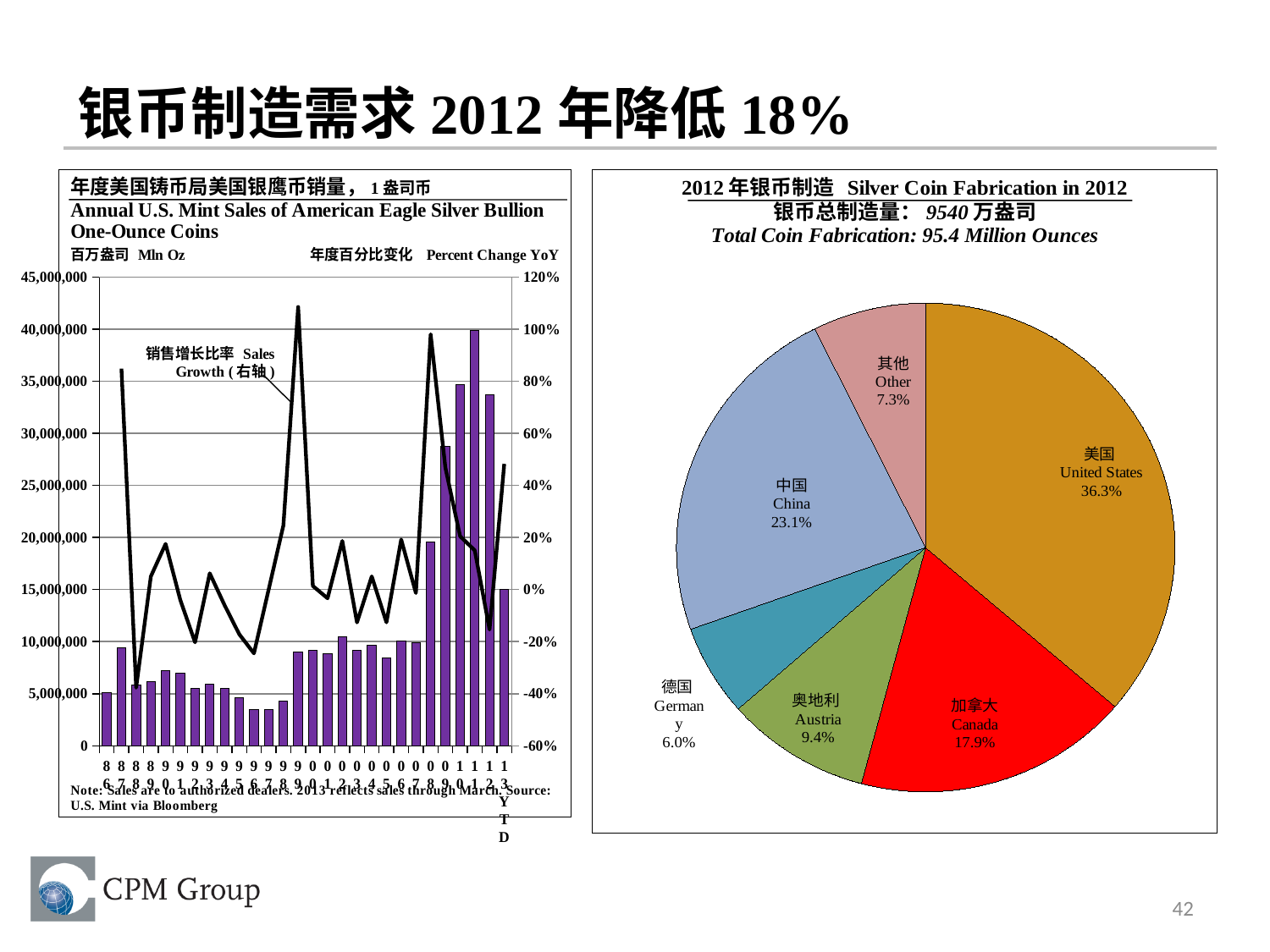
In the Silver Coin Fabrication in 2012 pie chart, what share does Canada have? 17.9% In the Silver Coin Fabrication in 2012 pie chart, what share does China have? 23.1% In the Silver Coin Fabrication in 2012 pie chart, what share does Germany have? 6.0% How many slices does the Silver Coin Fabrication in 2012 pie chart have? 6 In the Annual U.S. Mint Sales of American Eagle Silver Bullion One-Ounce Coins chart, is the tallest bar greater or less than 35,000,000? greater In the Silver Coin Fabrication in 2012 pie chart, which named slice has the smallest share? Germany In the Silver Coin Fabrication in 2012 pie chart, which country has the largest share? United States In the Silver Coin Fabrication in 2012 pie chart, what share does the United States have? 36.3% What kind of chart is the chart on the right side of the slide? Pie chart In the Silver Coin Fabrication in 2012 pie chart, how many percentage points larger is the United States share than the Canada share? 18.4 In the Silver Coin Fabrication in 2012 pie chart, which is larger, Austria or Other? Austria What total coin fabrication is stated on the Silver Coin Fabrication in 2012 chart? 95.4 Million Ounces